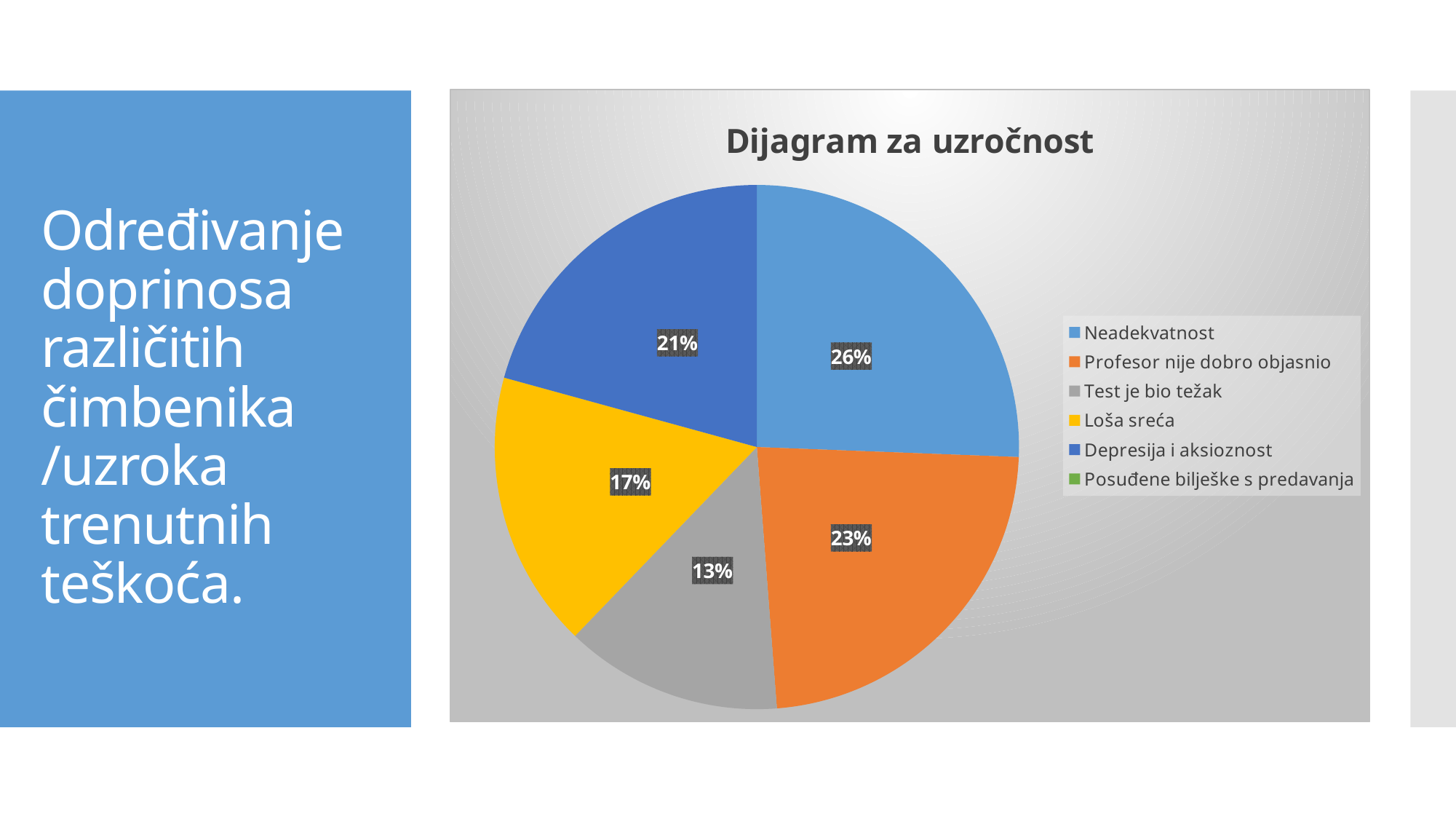
Which labelled slice of the pie is the smallest? Test je bio težak What is the title of the chart? Dijagram za uzročnost Which category has the largest slice of the pie? Neadekvatnost What share of the pie does Profesor nije dobro objasnio have? 23% What is the difference in percentage points between Neadekvatnost and Test je bio težak? 13 How many entries does the legend list? 6 What share of the pie does Depresija i aksioznost have? 21% What kind of chart is shown on the slide? pie chart Which is larger, the share for Loša sreća or the share for Depresija i aksioznost? Depresija i aksioznost What share of the pie does Test je bio težak have? 13%